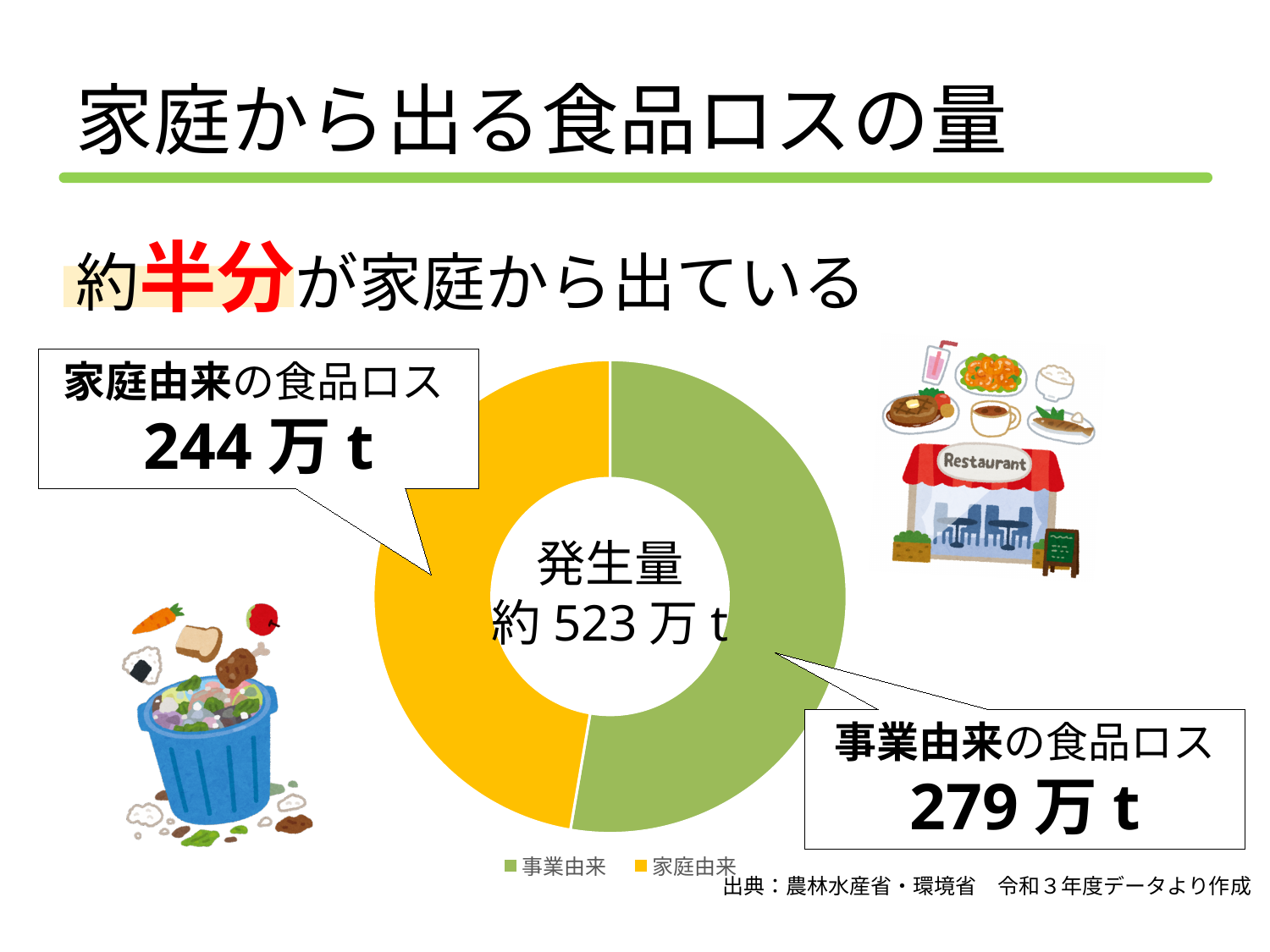
What colour is the 家庭由来 segment of the donut chart? Yellow Which category has the larger value in the donut chart? 事業由来 What is the value for 家庭由来の食品ロス in the donut chart? 244万t What total amount (発生量) is shown in the centre of the donut chart? 約523万t Which category has the smaller value in the donut chart? 家庭由来 What is the title of the slide containing the chart? 家庭から出る食品ロスの量 What is the difference between the 事業由来 value and the 家庭由来 value? 35万t How many categories are shown in the donut chart? 2 Is the value for 事業由来 larger or smaller than the value for 家庭由来? larger What kind of chart is shown on the slide? Donut (pie) chart How many entries does the chart legend list? 2 What is the value for 事業由来の食品ロス in the donut chart? 279万t